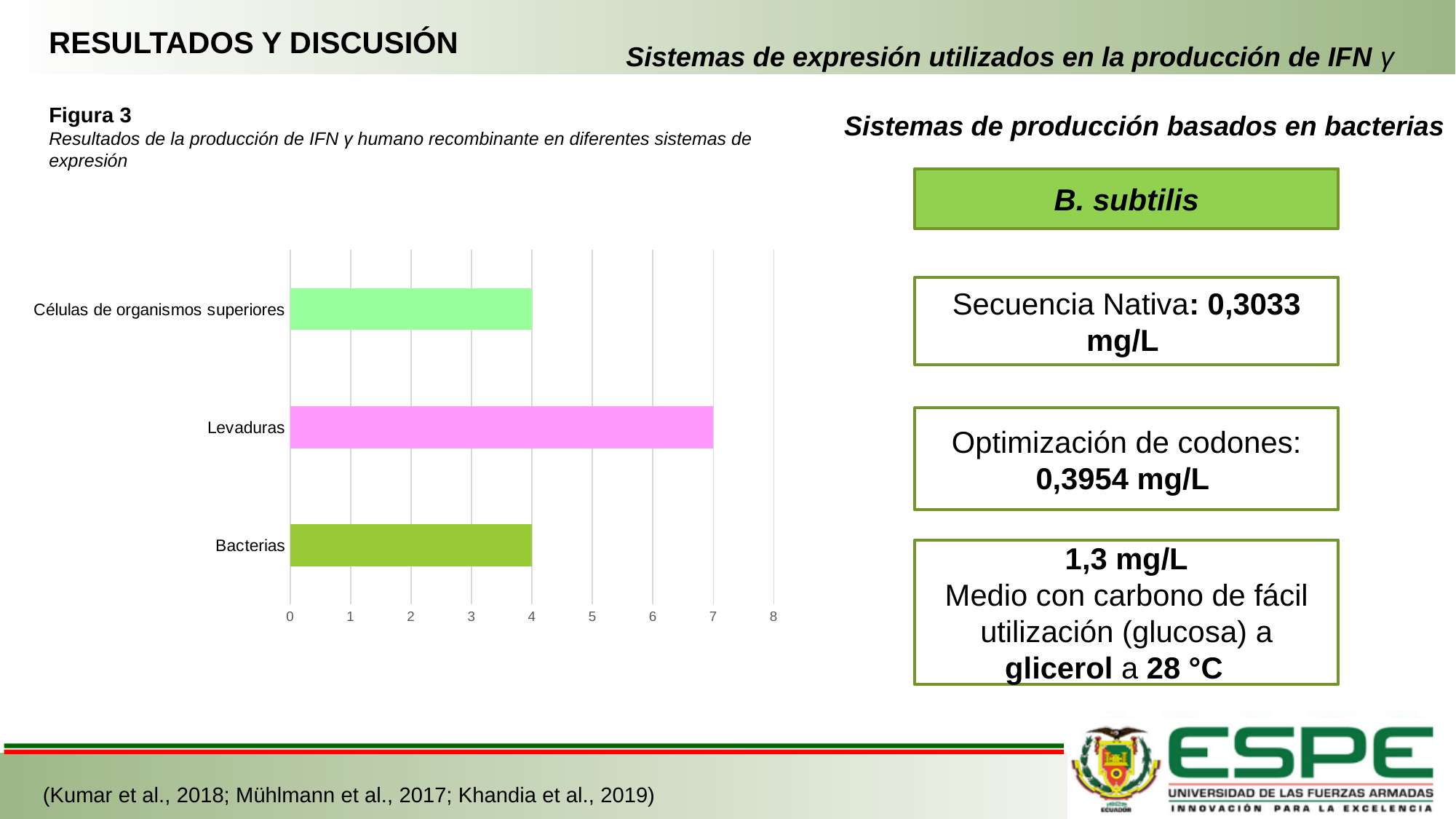
What kind of chart is shown in Figura 3? Bar chart What is the highest value shown on the x axis of the Figura 3 chart? 8 What is the difference between the values for Levaduras and Bacterias in the Figura 3 chart? 3 How many categories are shown in the Figura 3 chart? 3 What is the value for Levaduras in the Figura 3 bar chart? 7 Is the value for Levaduras in the Figura 3 chart greater or less than 5? greater What is the value for Células de organismos superiores in the Figura 3 bar chart? 4 What colour is the bar for Levaduras in the Figura 3 chart? Pink Which category has the highest value in the Figura 3 bar chart? Levaduras What is the value for Bacterias in the Figura 3 bar chart? 4 Is the value for Bacterias in the Figura 3 chart greater or less than 6? less Which has a larger value in the Figura 3 chart, Levaduras or Bacterias? Levaduras